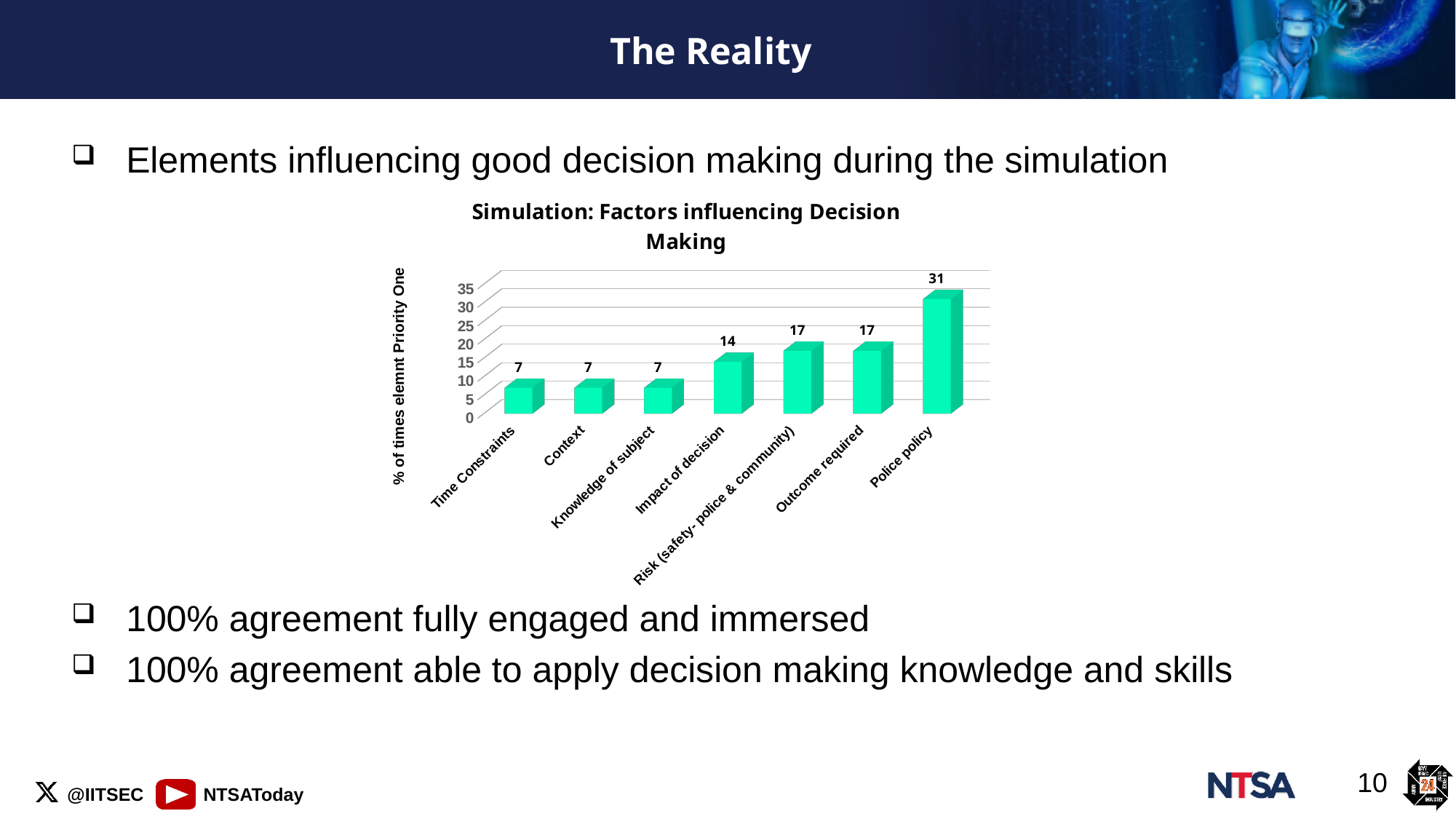
How many categories are shown on the x axis? 7 Which is larger, the value for Impact of decision or the value for Knowledge of subject? Impact of decision Which category has the highest value? Police policy What is the difference between the values for Police policy and Impact of decision? 17 Is the value for Police policy greater or less than 25? greater What is the difference between the values for Outcome required and Context? 10 What is the value for Outcome required? 17 What is the title of the chart? Simulation: Factors influencing Decision Making What is the value for Police policy? 31 What is the value for Impact of decision? 14 Do the values generally rise or fall from left to right along the x axis? rise What kind of chart is shown? bar chart